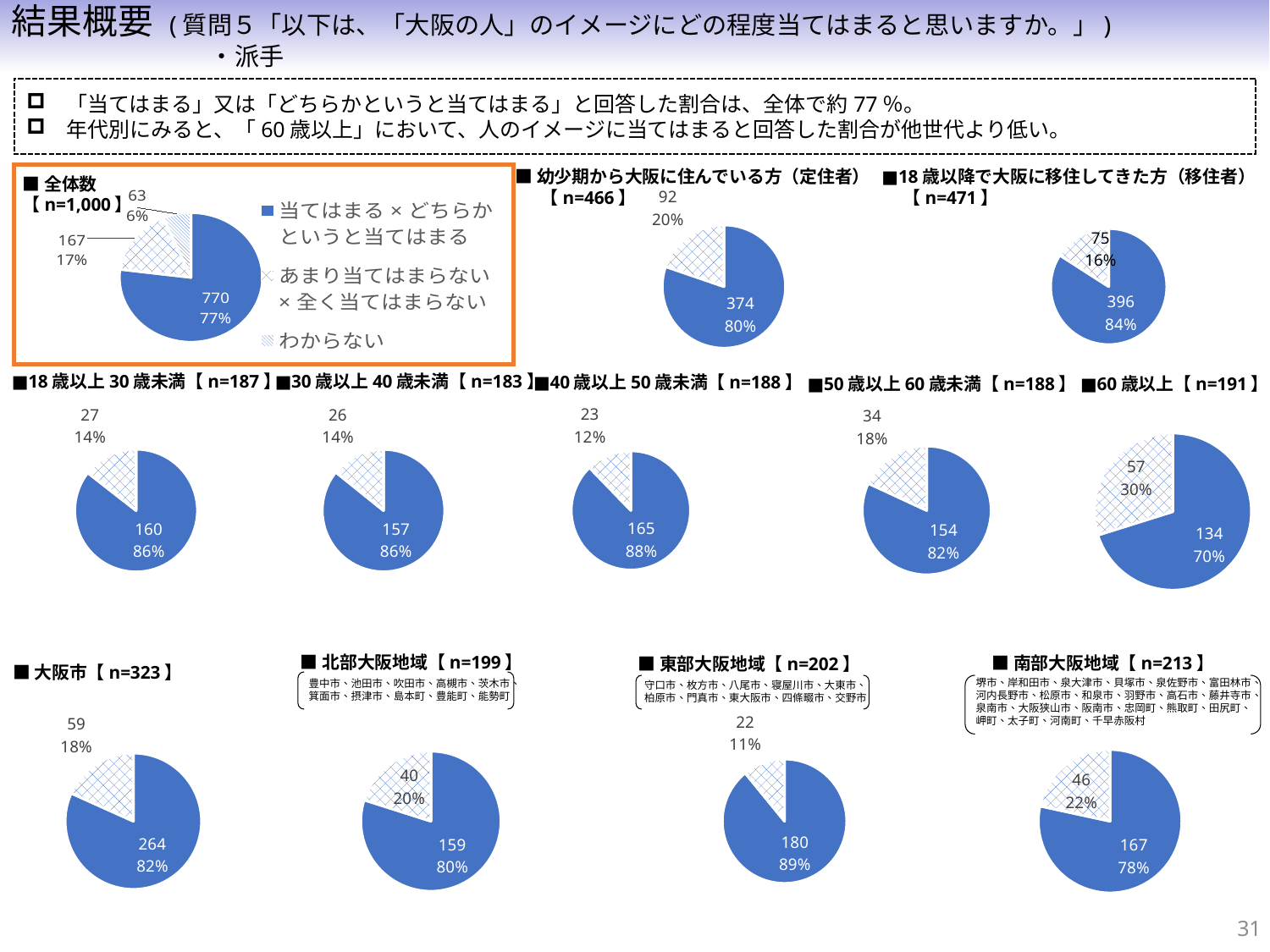
In the 60歳以上【n=191】 pie chart, what is the value of the 「あまり当てはまらない × 全く当てはまらない」 slice? 57 Among the five age-group pie charts, which age group has the lowest percentage for 「当てはまる × どちらかというと当てはまる」? 60歳以上 In the 全体数【n=1,000】 pie chart, what is the value for 「当てはまる × どちらかというと当てはまる」? 770 In the 全体数【n=1,000】 pie chart, what share of the pie is 「あまり当てはまらない × 全く当てはまらない」? 17% How many entries does the legend of the 全体数【n=1,000】 pie chart list? 3 Which has a larger 「当てはまる × どちらかというと当てはまる」 percentage: the 北部大阪地域【n=199】 chart or the 南部大阪地域【n=213】 chart? 北部大阪地域 In the 東部大阪地域【n=202】 pie chart, what is the value of the 「あまり当てはまらない × 全く当てはまらない」 slice? 22 How many slices does the 全体数【n=1,000】 pie chart have? 3 Among the five age-group pie charts, which age group has the highest percentage for 「当てはまる × どちらかというと当てはまる」? 40歳以上50歳未満 In the 18歳以降で大阪に移住してきた方（移住者）【n=471】 pie chart, what percentage is shown for the 「当てはまる × どちらかというと当てはまる」 slice? 84% What is the difference between the 「当てはまる × どちらかというと当てはまる」 values in the 大阪市【n=323】 chart (264) and the 東部大阪地域【n=202】 chart (180)? 84 What kind of chart is used for 幼少期から大阪に住んでいる方（定住者）【n=466】? Pie chart